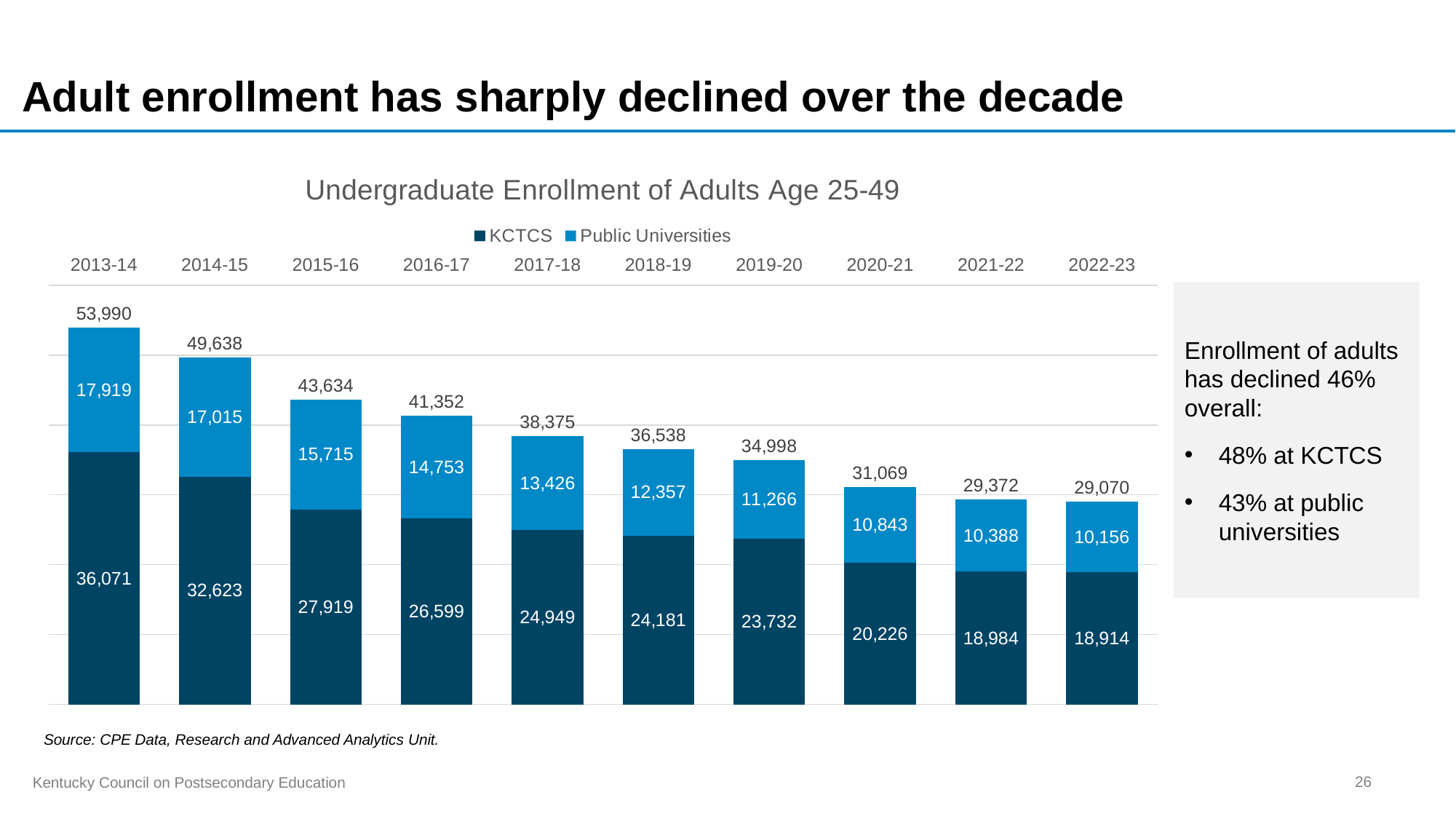
What is the KCTCS enrollment value for 2013-14? 36,071 What kind of chart is shown on the slide? Stacked bar chart What is the title of the chart? Undergraduate Enrollment of Adults Age 25-49 How many series does the legend list? 2 Which is larger: the Public Universities enrollment in 2016-17 or in 2017-18? 2016-17 What is the difference between the KCTCS enrollment in 2013-14 and in 2022-23? 17,157 How many academic years are shown on the x axis? 10 Do the total enrollment values rise or fall from 2013-14 to 2022-23? Fall What is the Public Universities enrollment value for 2022-23? 10,156 What is the total enrollment shown for 2018-19? 36,538 Which year has the lowest KCTCS enrollment? 2022-23 Which year has the highest total enrollment? 2013-14